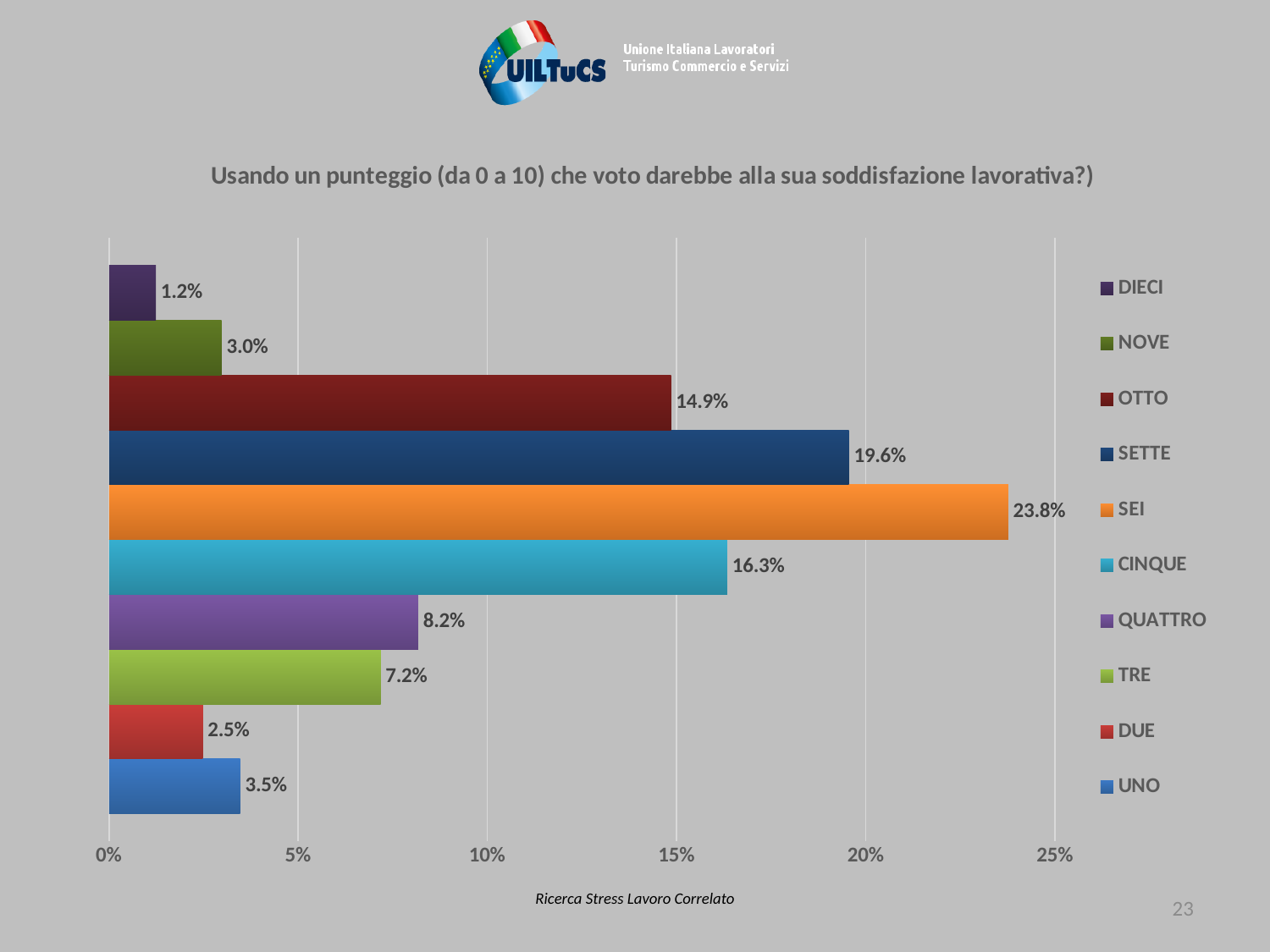
What is the value for OTTO? 14.9% Which is larger, the value for QUATTRO or the value for TRE? QUATTRO What is the value for UNO? 3.5% Is the value for CINQUE greater or less than 15%? greater What is the difference between the values for SETTE and CINQUE? 3.3% What kind of chart is shown on the slide? bar chart Which category has the highest value? SEI How many entries does the legend list? 10 What is the value for SEI? 23.8% What is the title of the chart? Usando un punteggio (da 0 a 10) che voto darebbe alla sua soddisfazione lavorativa?) How many bars are shown in the chart? 10 Which category has the lowest value? DIECI